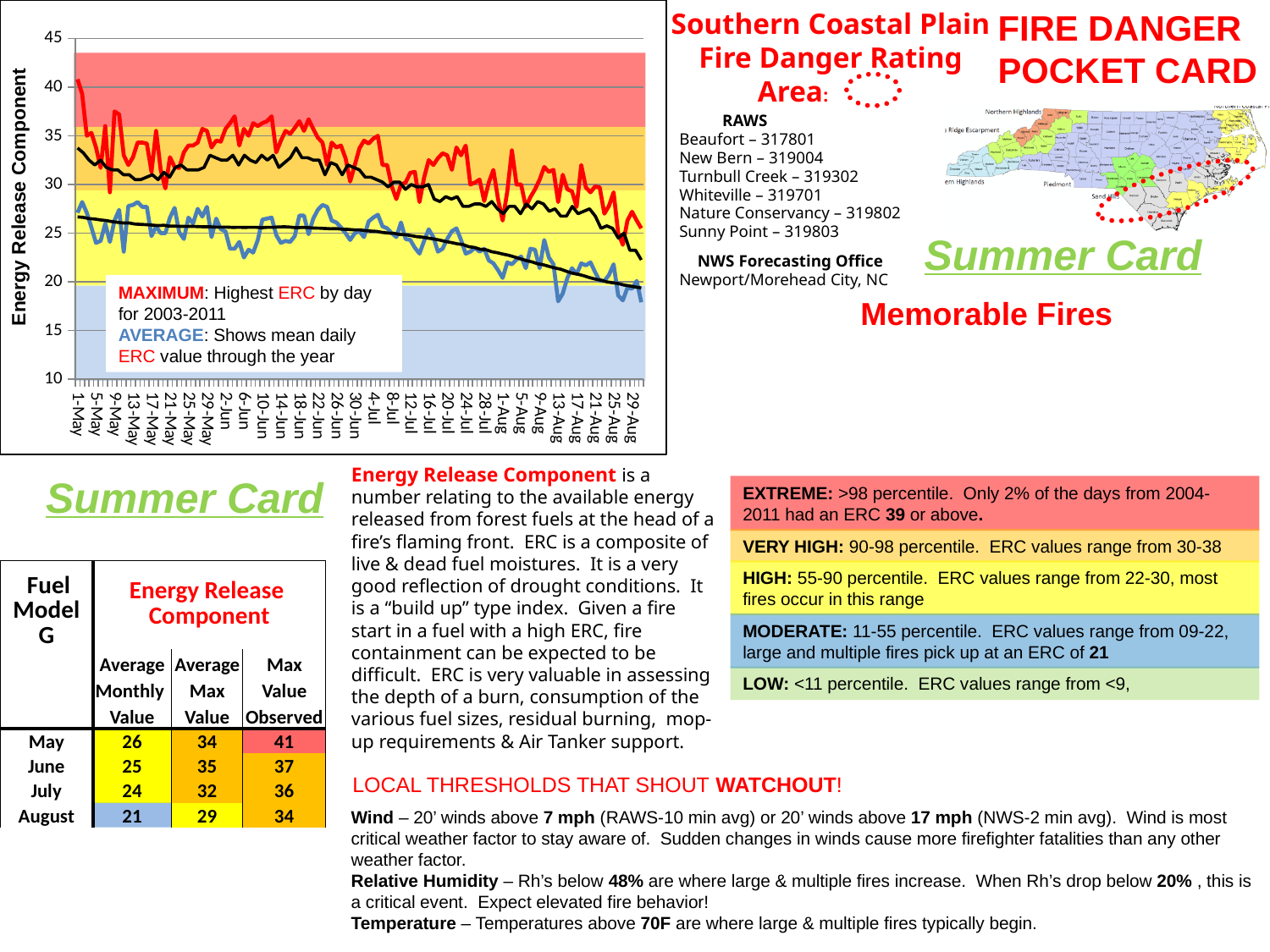
Which line shows the highest ERC by day for 2003-2011, according to the text box on the chart? MAXIMUM (red line) Which line is higher at 1-May, the red MAXIMUM line or the blue AVERAGE line? red MAXIMUM line Is the red MAXIMUM line at 29-Aug greater or less than 30? less Is the blue AVERAGE line at 29-Aug greater or less than 20? less Is the red MAXIMUM line at 1-May greater or less than 35? greater What is the first date label on the horizontal axis of the chart? 1-May What is the lowest value shown on the vertical axis of the chart? 10 What is the title of the vertical axis of the chart? Energy Release Component What kind of chart is shown on the slide? line chart Does the black trend line for the AVERAGE ERC rise or fall from May to August? fall What is the highest value shown on the vertical axis of the chart? 45 What is the last date label on the horizontal axis of the chart? 29-Aug